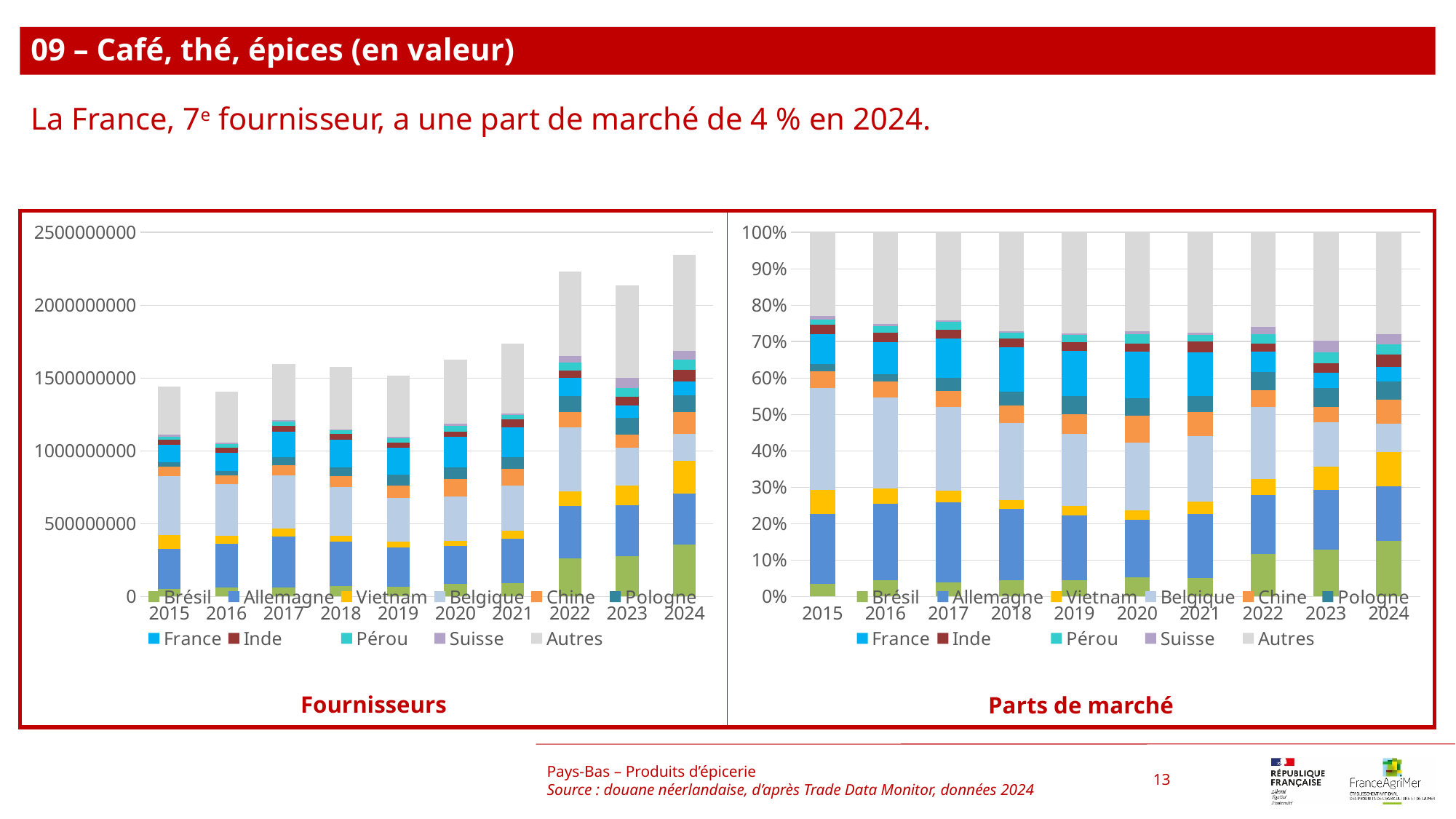
In the 'Parts de marché' chart, is the Brésil share in 2024 greater or less than 10%? greater In the 'Fournisseurs' chart, which year has the shortest total bar? 2016 In the 'Fournisseurs' chart, is the total bar for 2015 greater or less than 1500000000? less In the 'Parts de marché' chart, what is the top value shown on the y axis? 100% Which series is listed first in the legend of the 'Fournisseurs' chart? Brésil How many years are shown on the x axis of the 'Fournisseurs' chart? 10 In the 'Fournisseurs' chart, is the total bar for 2024 greater or less than 2000000000? greater In the 'Fournisseurs' chart, which year has the tallest total bar? 2024 In the 'Fournisseurs' chart, do the total bars generally rise or fall from 2015 to 2024? rise How many series does the legend of the 'Parts de marché' chart list? 11 What kind of chart is the 'Fournisseurs' chart on the left? Stacked bar chart In the 'Fournisseurs' chart, which total bar is larger, 2021 or 2022? 2022